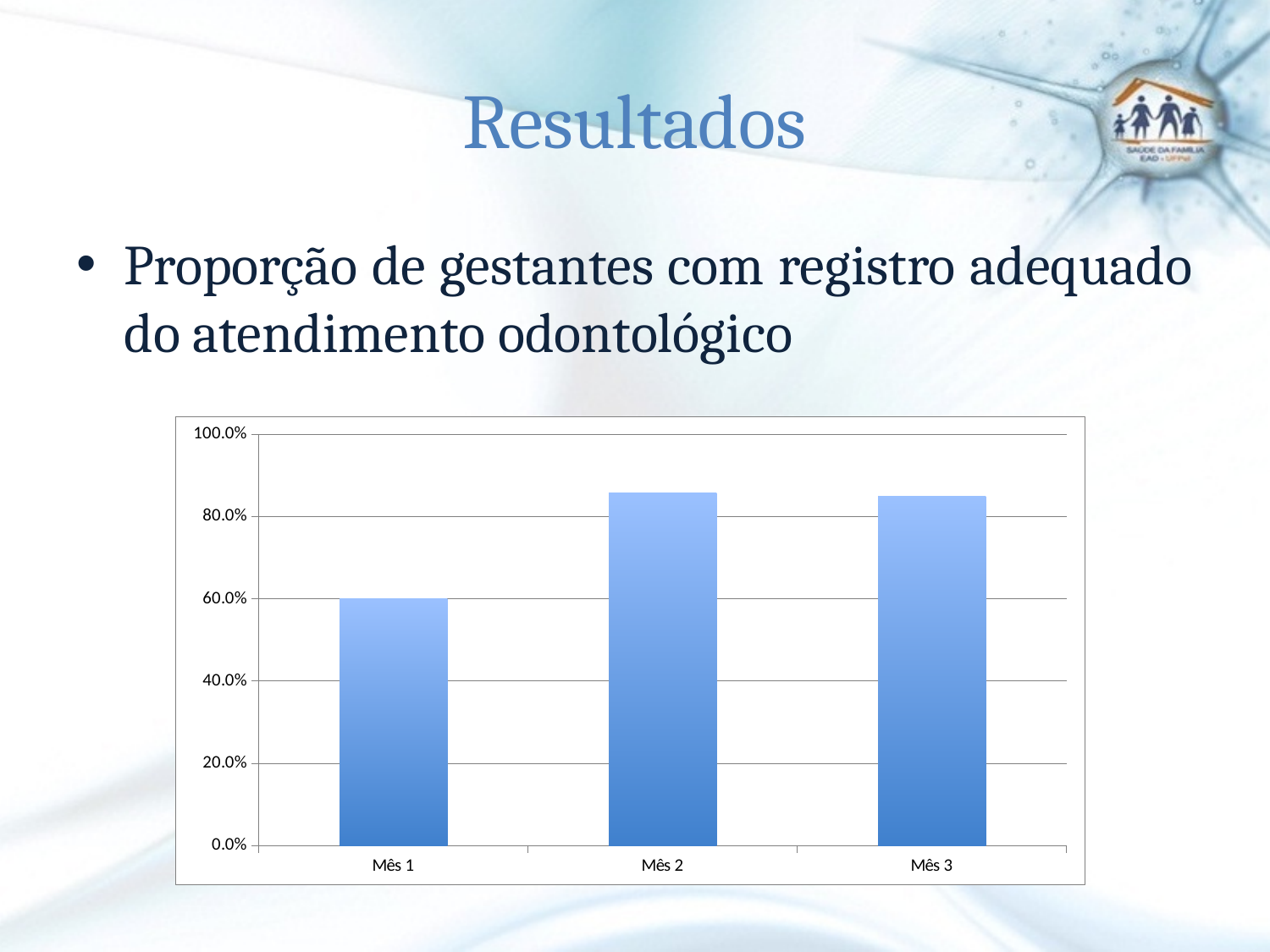
Which is larger, the value for Mês 1 or the value for Mês 2? Mês 2 What kind of chart is shown on the slide? bar chart What is the value for Mês 1? 60.0% Is the value for Mês 1 greater or less than 80.0%? less Is the value for Mês 3 greater or less than 80.0%? greater Which month has the lowest value on the chart? Mês 1 Does the value rise or fall from Mês 1 to Mês 2? rise Is the value for Mês 2 greater or less than 100.0%? less How many categories (months) are plotted on the chart? 3 What is the highest value shown on the vertical axis of the chart? 100.0% Which is larger, the value for Mês 1 or the value for Mês 3? Mês 3